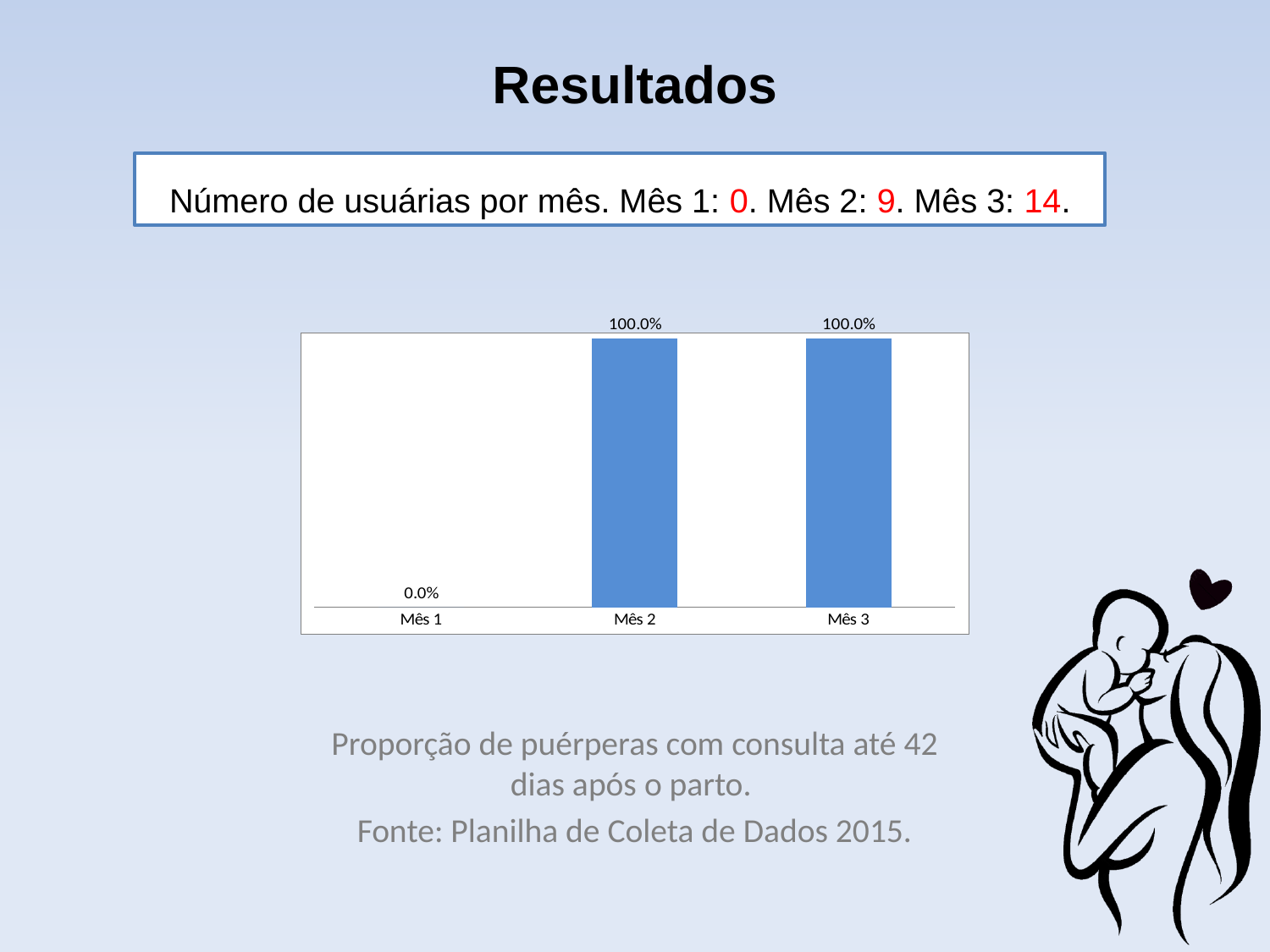
What is the caption below the chart describing what it shows? Proporção de puérperas com consulta até 42 dias após o parto. Which is larger, the value for Mês 1 or the value for Mês 3? Mês 3 What is the value for Mês 3? 100.0% How many categories are shown on the x axis of the chart? 3 What is the value for Mês 1? 0.0% Do the values rise or fall from Mês 1 to Mês 2? rise What kind of chart is shown on the slide? bar chart What is the difference between the values for Mês 2 and Mês 1? 100.0% What is the value for Mês 2? 100.0% Which category has the lowest value? Mês 1 What colour are the bars in the chart? blue